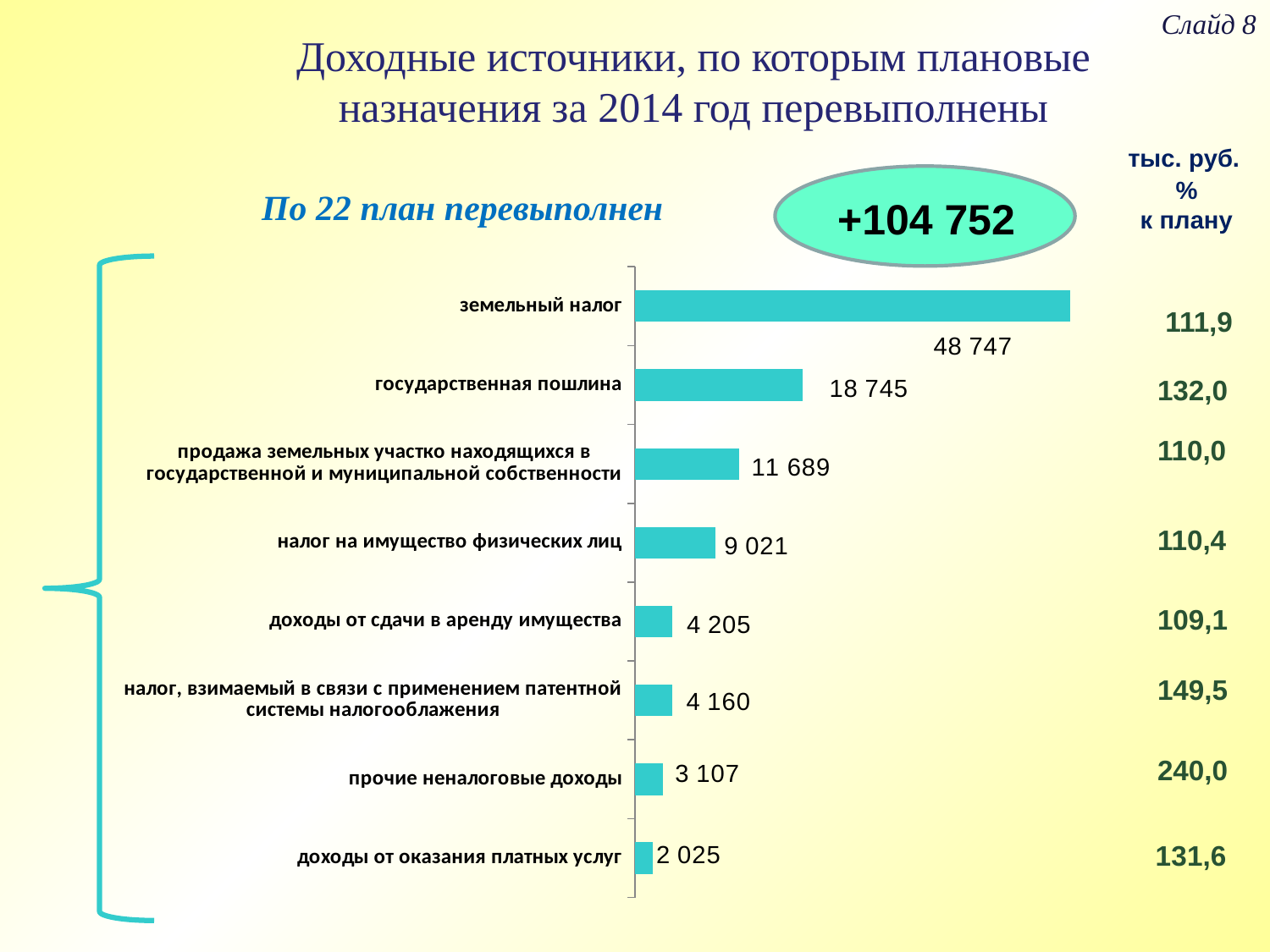
What total figure is shown in the oval above the chart? +104 752 How many categories are shown in the bar chart? 8 Which is larger: the value for прочие неналоговые доходы or the value for доходы от оказания платных услуг? прочие неналоговые доходы What is the value for налог на имущество физических лиц? 9 021 Which category has the lowest value? доходы от оказания платных услуг What kind of chart is shown on the slide? bar chart Which category has the highest value? земельный налог What is the difference between the values for доходы от сдачи в аренду имущества and налог, взимаемый в связи с применением патентной системы налогооблажения? 45 What is the difference between the values for земельный налог and государственная пошлина? 30 002 What is the value for доходы от оказания платных услуг? 2 025 What is the value for государственная пошлина? 18 745 What is the value for земельный налог? 48 747